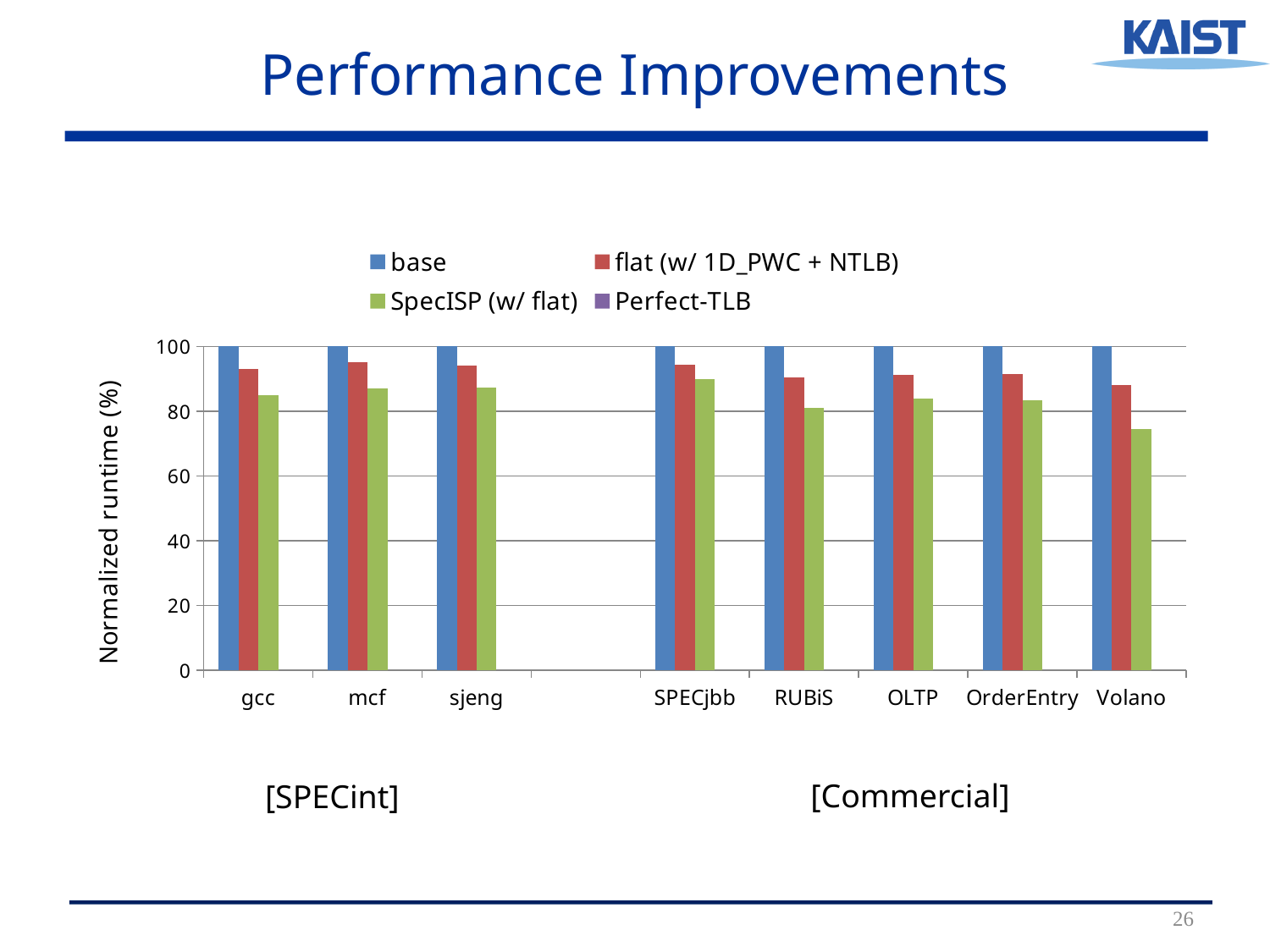
Is the SpecISP (w/ flat) value for Volano greater or less than 80? less What kind of chart is shown on the slide? bar chart Is the SpecISP (w/ flat) value for gcc greater or less than 80? greater What is the base value for gcc? 100 What is the base value for Volano? 100 How many labeled categories are shown on the x axis? 8 Which category has the lowest SpecISP (w/ flat) value? Volano Is the flat (w/ 1D_PWC + NTLB) value for Volano greater or less than 80? greater How many series does the legend list? 4 Which is larger: the SpecISP (w/ flat) value for SPECjbb or for OLTP? SPECjbb Which is larger: the flat (w/ 1D_PWC + NTLB) value for mcf or for Volano? mcf What is the label of the y axis? Normalized runtime (%)